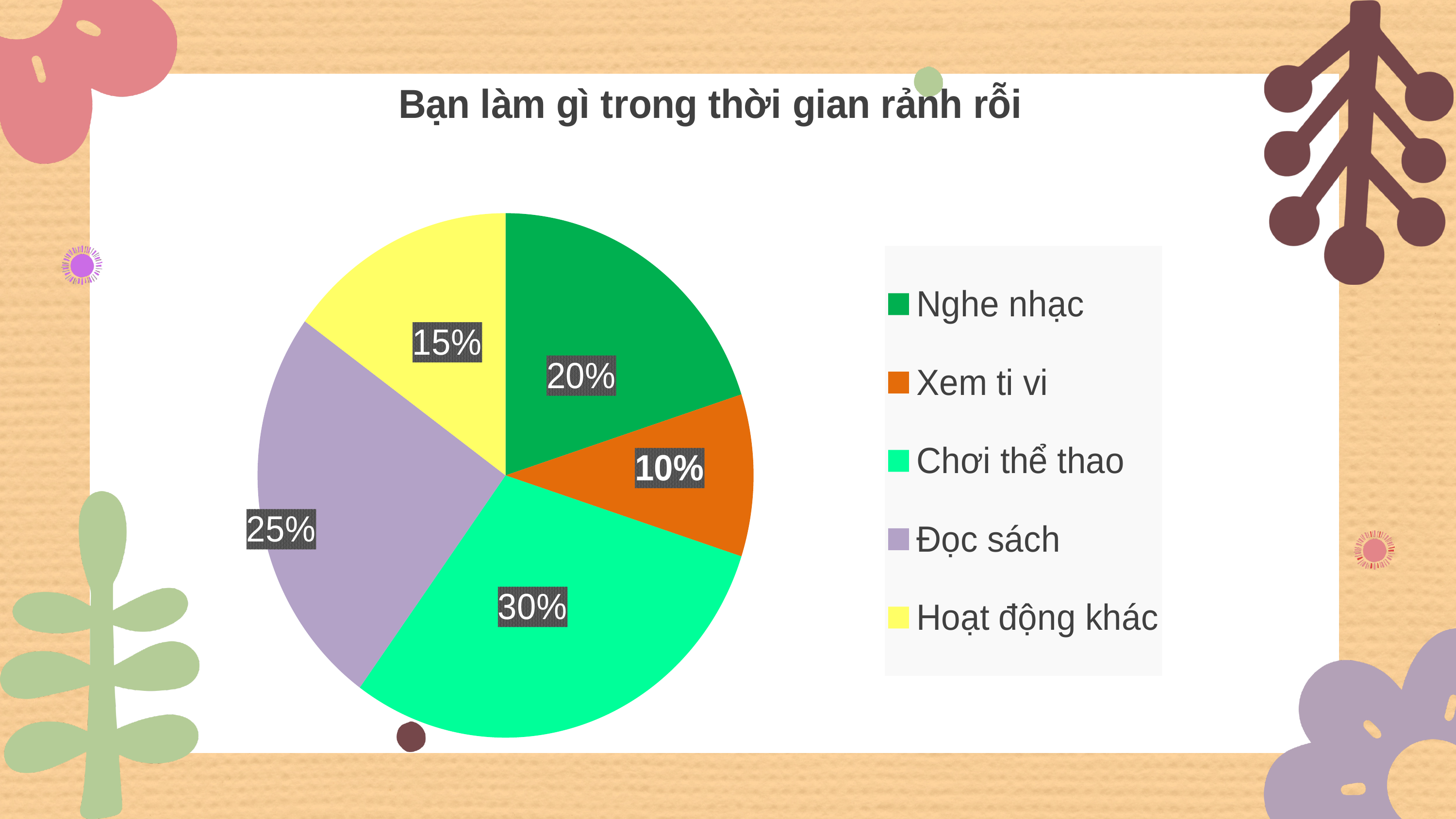
Which is larger, the share for Nghe nhạc or the share for Hoạt động khác? Nghe nhạc Which category has the smallest share of the pie? Xem ti vi What is the difference between the shares for Chơi thể thao and Đọc sách? 5% What is the title of the chart? Bạn làm gì trong thời gian rảnh rỗi What percentage is shown for Chơi thể thao? 30% Which category has the largest share of the pie? Chơi thể thao What type of chart is shown on the slide? Pie chart What percentage is shown for Xem ti vi? 10% What percentage is shown for Nghe nhạc? 20% How many categories does the legend list? 5 What percentage is shown for Hoạt động khác? 15% What percentage is shown for Đọc sách? 25%